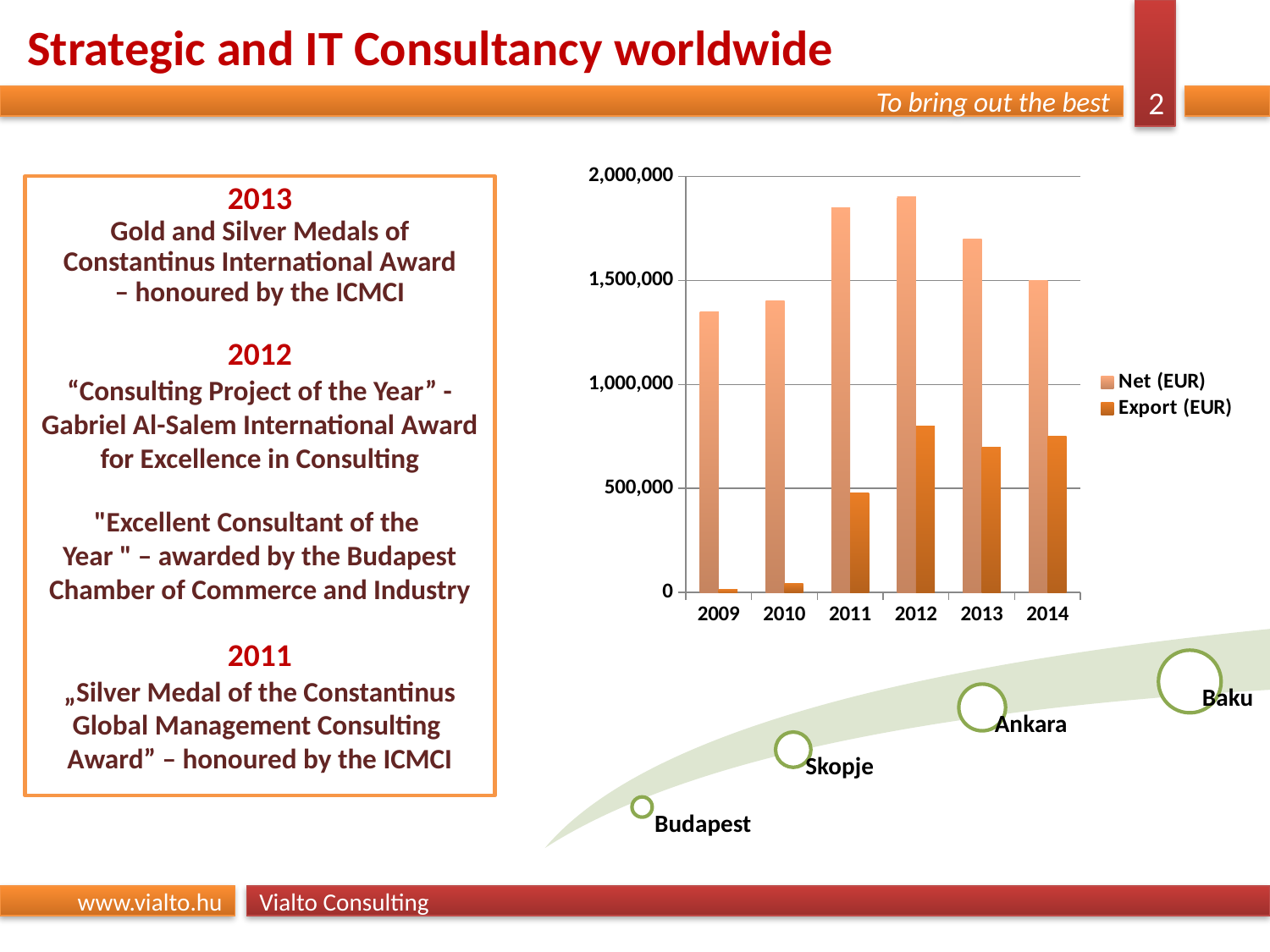
Is the Net (EUR) value for 2011 greater or less than 1,500,000? greater Is the Export (EUR) value for 2012 greater or less than 500,000? greater Which year has the lowest Net (EUR) value? 2009 What are the two series named in the chart legend? Net (EUR) and Export (EUR) Which is larger, the Net (EUR) value for 2013 or for 2014? 2013 How many series does the chart legend list? 2 What kind of chart is shown on the slide? bar chart How many years are shown on the x axis of the chart? 6 Which year has the lowest Export (EUR) value? 2009 Does the Export (EUR) value rise or fall from 2009 to 2012? rise Which year has the highest Export (EUR) value? 2012